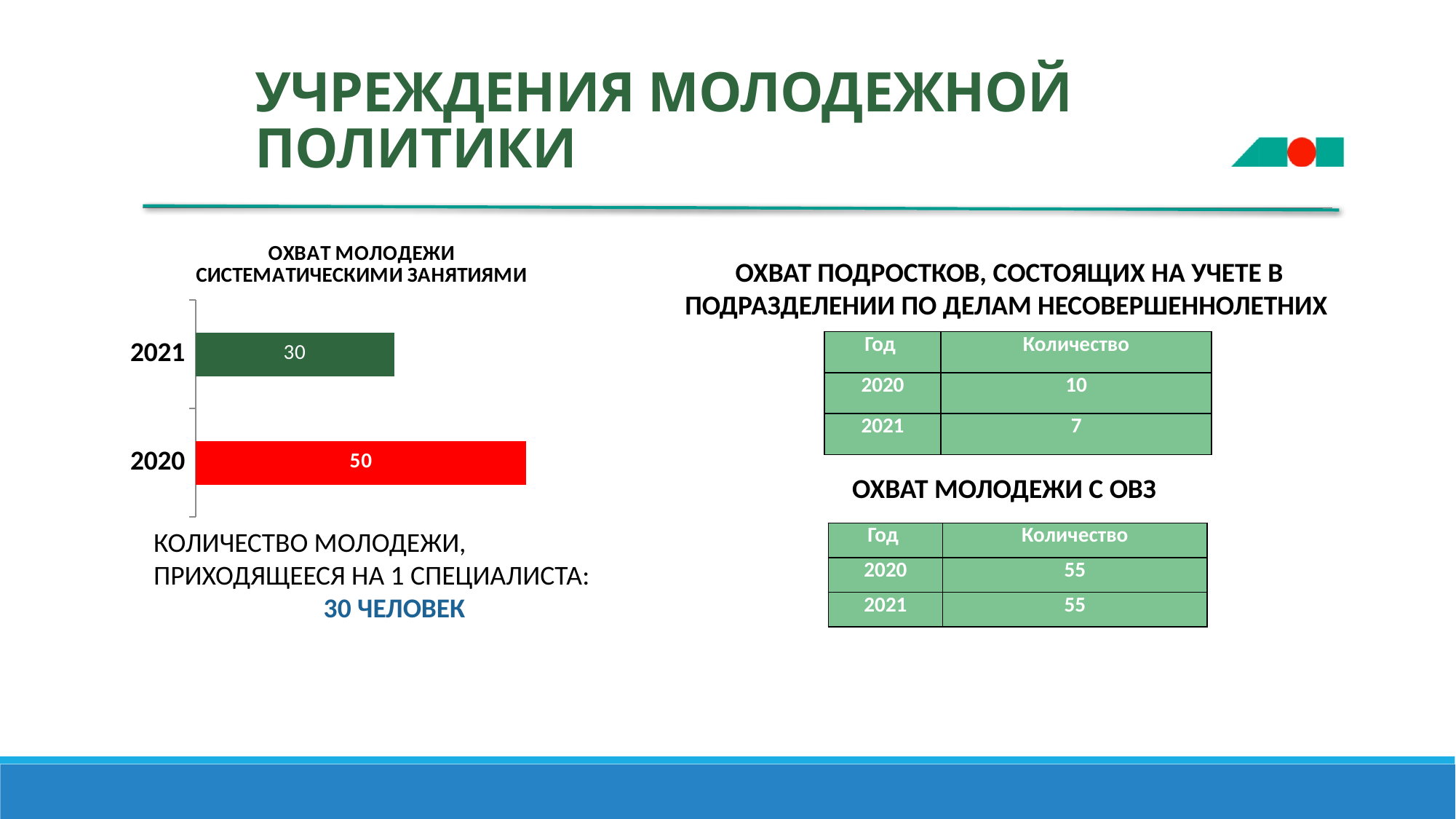
In the chart "ОХВАТ МОЛОДЕЖИ СИСТЕМАТИЧЕСКИМИ ЗАНЯТИЯМИ", what is the value for 2020? 50 How many categories (years) are shown in the chart "ОХВАТ МОЛОДЕЖИ СИСТЕМАТИЧЕСКИМИ ЗАНЯТИЯМИ"? 2 In the chart "ОХВАТ МОЛОДЕЖИ СИСТЕМАТИЧЕСКИМИ ЗАНЯТИЯМИ", what colour is the bar for 2021? Dark green In the chart "ОХВАТ МОЛОДЕЖИ СИСТЕМАТИЧЕСКИМИ ЗАНЯТИЯМИ", which is larger: the value for 2020 or the value for 2021? 2020 In the chart "ОХВАТ МОЛОДЕЖИ СИСТЕМАТИЧЕСКИМИ ЗАНЯТИЯМИ", what is the difference between the values for 2020 and 2021? 20 In the chart "ОХВАТ МОЛОДЕЖИ СИСТЕМАТИЧЕСКИМИ ЗАНЯТИЯМИ", which year has the highest value? 2020 In the chart "ОХВАТ МОЛОДЕЖИ СИСТЕМАТИЧЕСКИМИ ЗАНЯТИЯМИ", which year has the lowest value? 2021 In the chart "ОХВАТ МОЛОДЕЖИ СИСТЕМАТИЧЕСКИМИ ЗАНЯТИЯМИ", did the value rise or fall from 2020 to 2021? Fall In the chart "ОХВАТ МОЛОДЕЖИ СИСТЕМАТИЧЕСКИМИ ЗАНЯТИЯМИ", what is the value for 2021? 30 In the chart "ОХВАТ МОЛОДЕЖИ СИСТЕМАТИЧЕСКИМИ ЗАНЯТИЯМИ", what colour is the bar for 2020? Red What kind of chart is "ОХВАТ МОЛОДЕЖИ СИСТЕМАТИЧЕСКИМИ ЗАНЯТИЯМИ"? Bar chart